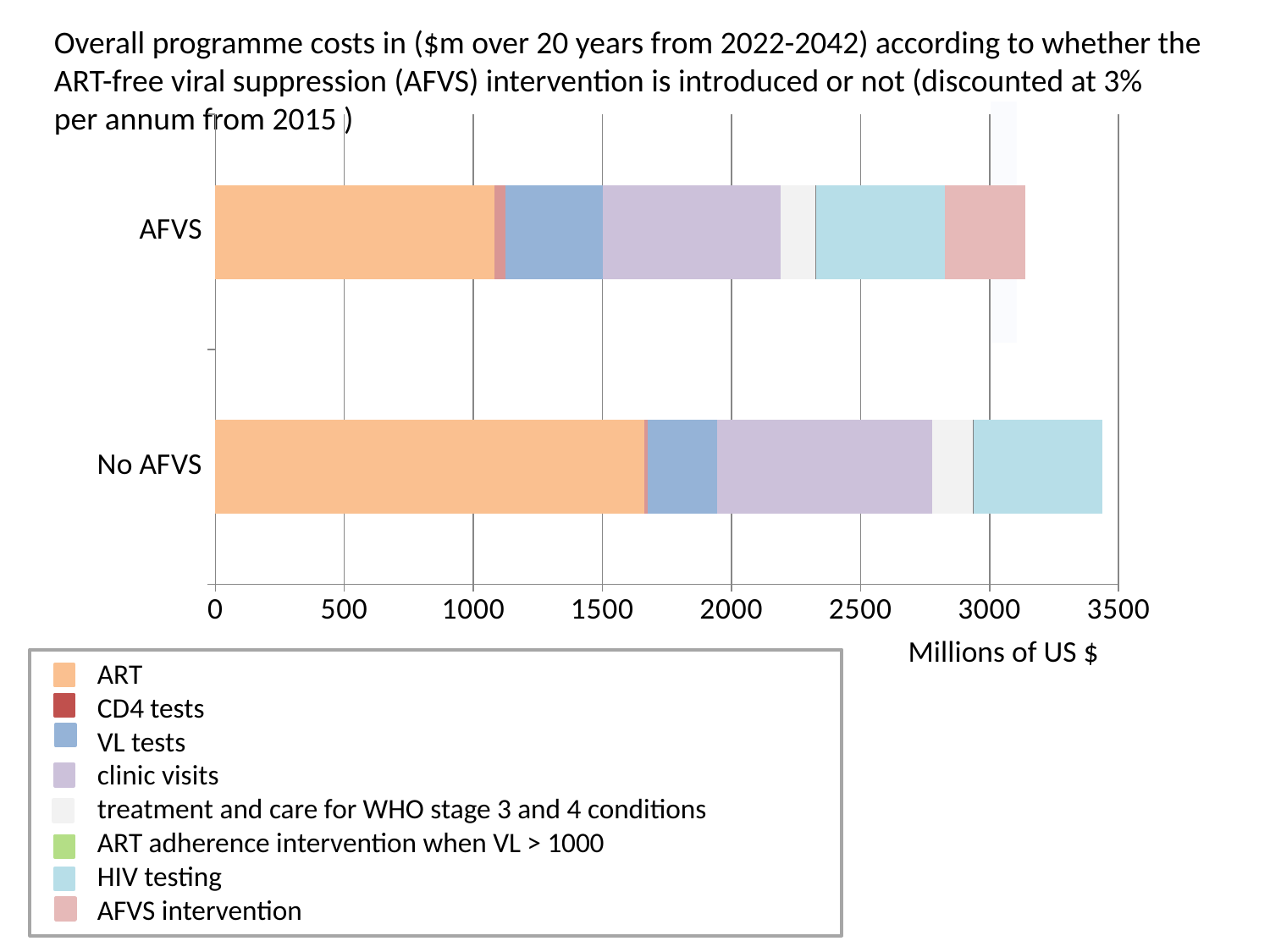
Which scenario has the larger total programme cost, AFVS or No AFVS? No AFVS Is the ART cost in the AFVS scenario greater or less than 1500? less Is the ART cost in the No AFVS scenario greater or less than 1500? greater Which legend entry is shown in orange? ART Is the total cost for the No AFVS bar greater or less than 3000? greater How many series does the legend list? 8 How many categories (bars) are plotted on the chart? 2 What is the label on the horizontal axis? Millions of US $ What type of chart is shown on the slide? stacked bar chart Which scenario has the larger ART cost, AFVS or No AFVS? No AFVS